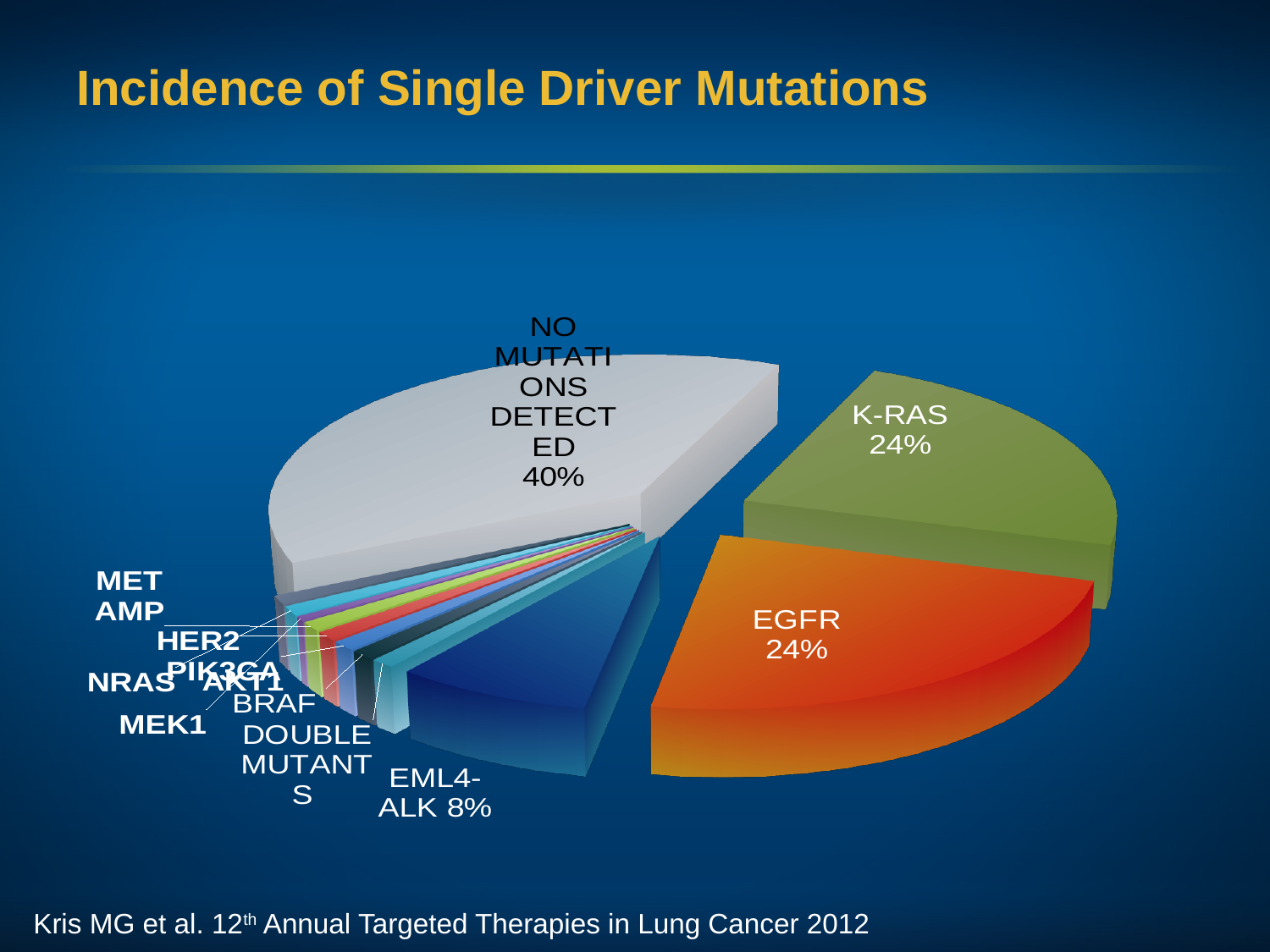
What is the share shown for EGFR? 24% What colour is the EGFR slice of the pie? Orange-red What percentage of the pie is labelled NO MUTATIONS DETECTED? 40% What is the title of the slide containing the pie chart? Incidence of Single Driver Mutations Which is larger, the EGFR slice or the EML4-ALK slice? EGFR What kind of chart is shown on the slide? Pie chart What is the share shown for EML4-ALK? 8% How many percentage points larger is the NO MUTATIONS DETECTED slice than the K-RAS slice? 16 percentage points What is the share shown for K-RAS? 24% What is the combined share of the EGFR and K-RAS slices? 48% Which slice of the pie is the largest? NO MUTATIONS DETECTED How many percentage points larger is the K-RAS slice than the EML4-ALK slice? 16 percentage points